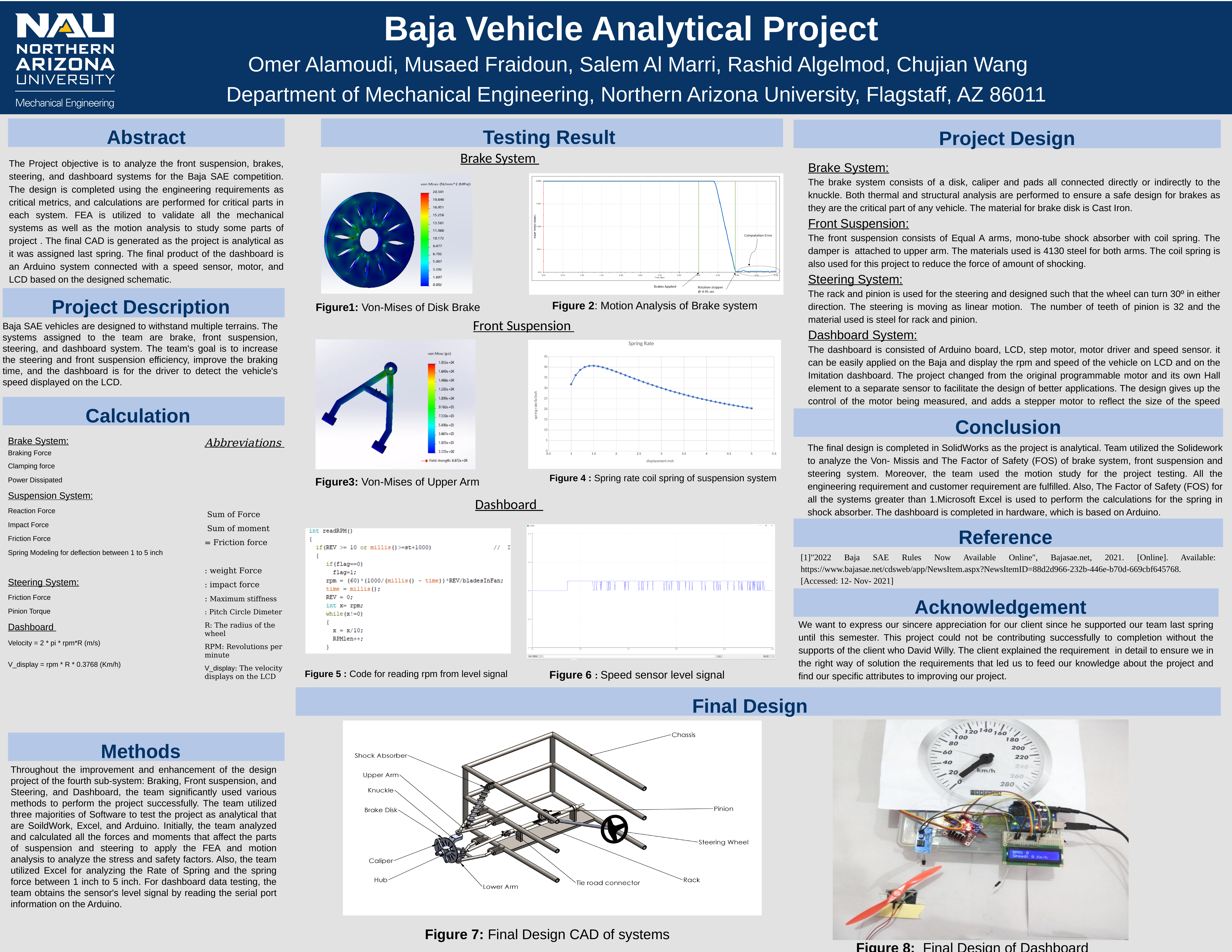
How many data series are plotted in the Figure 4 Spring Rate chart? 1 What type of chart is Figure 4 (Spring rate coil spring of suspension system)? line chart In the Figure 4 Spring Rate chart, which is larger: the spring rate at a displacement of 1.5 inches or at 4 inches? 1.5 inches In the Figure 4 Spring Rate chart, at which displacement is the spring rate lowest? 5 What is the highest value shown on the y axis of the Figure 4 Spring Rate chart? 45 In the Figure 4 Spring Rate chart, is the spring rate at a displacement of 5 inches greater or less than 25? less In the Figure 4 chart, what is the label of the x axis? displacement inch What is the title shown on the chart in Figure 4? Spring Rate In the Figure 4 Spring Rate chart, is the spring rate at a displacement of 4.5 inches greater or less than 30? less In the Figure 4 Spring Rate chart, is the spring rate at a displacement of 3 inches greater or less than 20? greater In the Figure 4 Spring Rate chart, does the spring rate rise or fall as displacement increases from 2 to 5 inches? fall